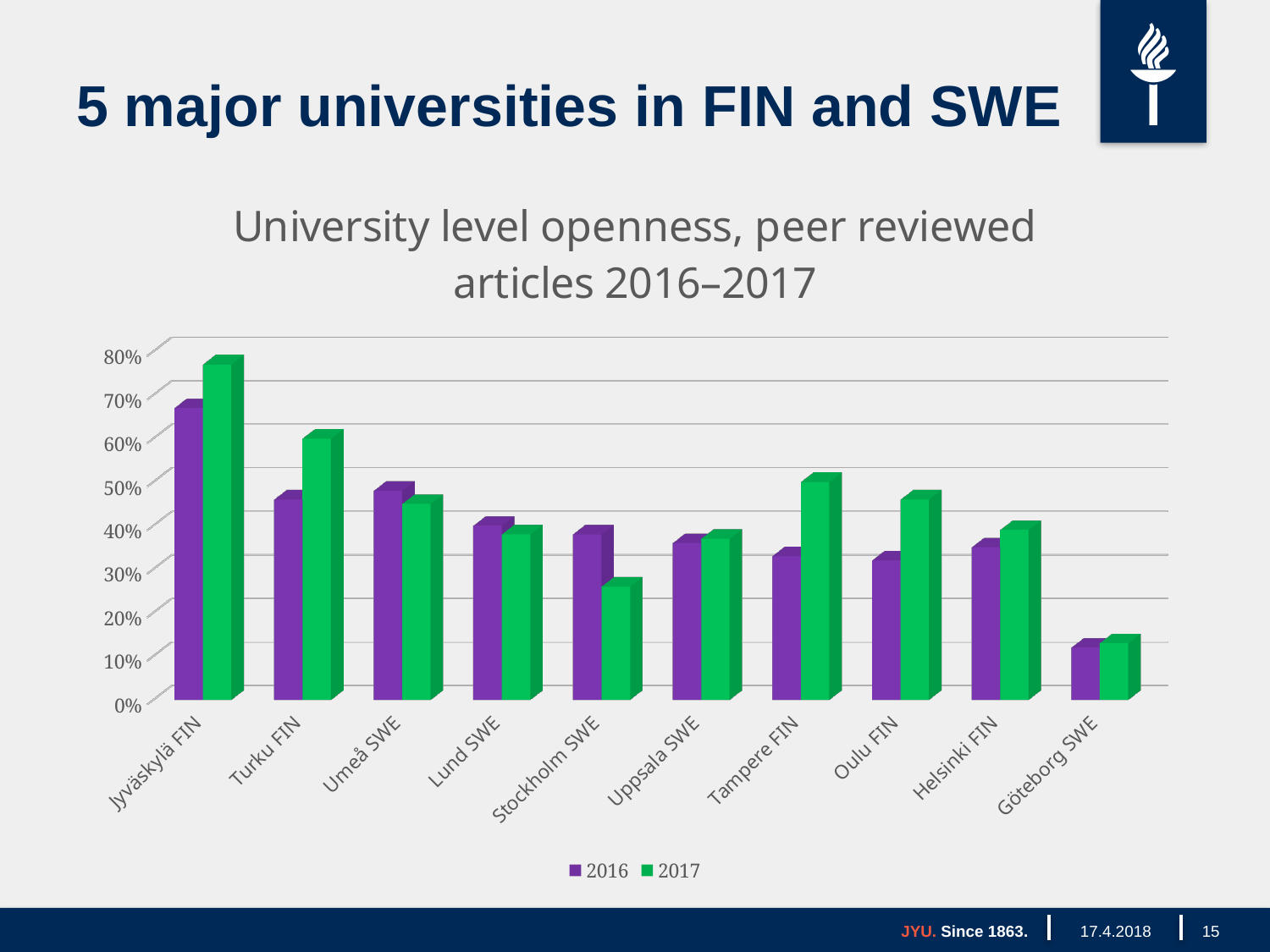
How many universities are shown on the x axis of the chart? 10 Is the 2017 value for Stockholm SWE greater or less than 30%? less How many series does the chart's legend list? 2 What kind of chart is shown on the slide? bar chart What is the title of the chart? University level openness, peer reviewed articles 2016–2017 Which university has the highest value for 2017? Jyväskylä FIN Which university has the lowest value for 2016? Göteborg SWE Which university has the lowest value for 2017? Göteborg SWE For Stockholm SWE, which year has the larger value, 2016 or 2017? 2016 Is the 2017 value for Jyväskylä FIN greater or less than 70%? greater For Tampere FIN, which year has the larger value, 2016 or 2017? 2017 Which university has the highest value for 2016? Jyväskylä FIN